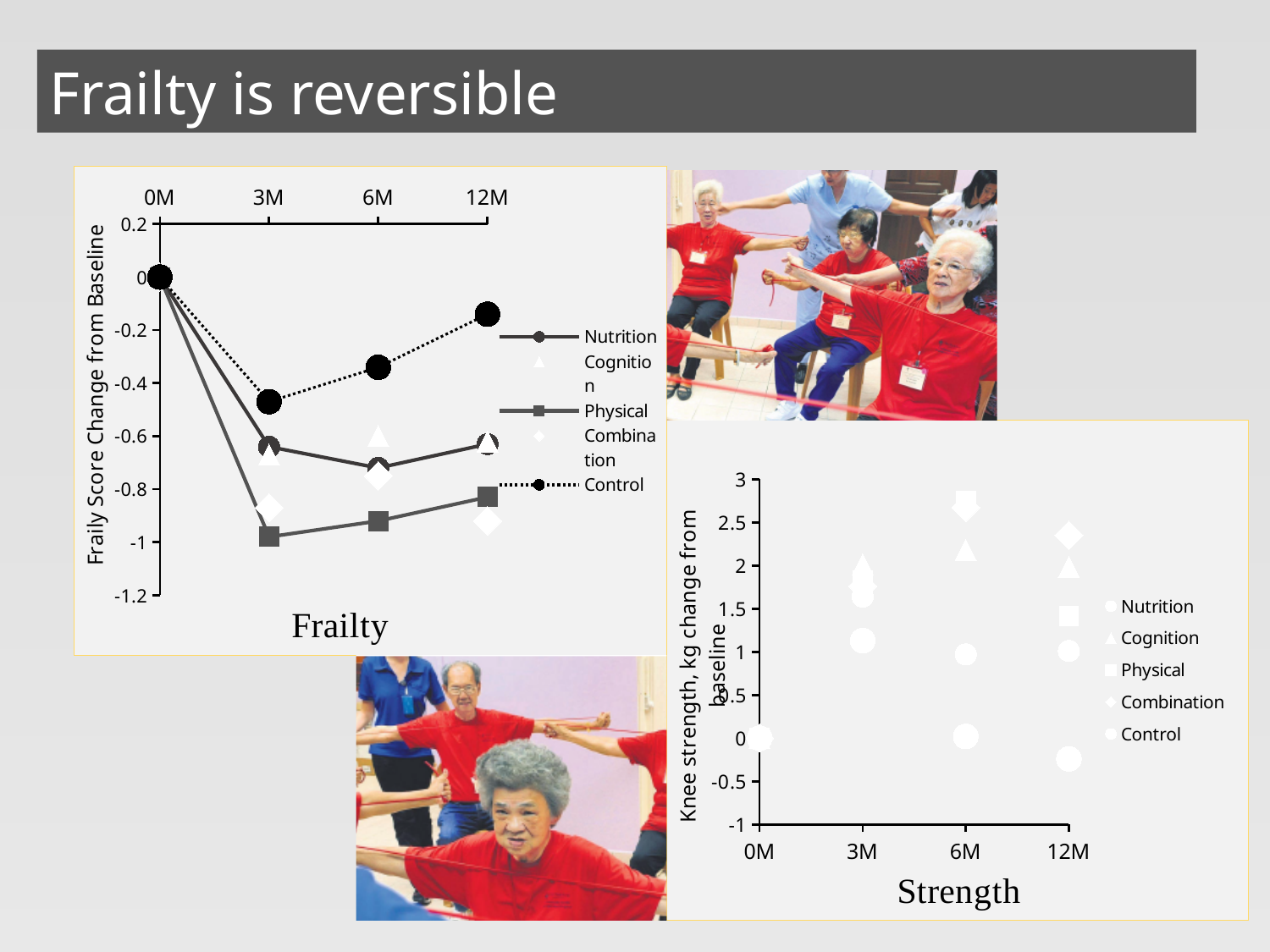
On the Frailty chart, is the value for Physical at 3M greater or less than -0.8? less On the Frailty chart, does the Control series rise or fall from 3M to 12M? rise On the Strength chart, how many series does the legend list? 5 On the Strength chart, what is the label on the y axis? Knee strength, kg change from baseline On the Strength chart, is the value for Control at 12M greater or less than 0? less On the Strength chart, is the value for Physical at 6M greater or less than 2.5? greater On the Frailty chart, what kind of chart is it? line chart On the Frailty chart, how many time points are shown on the x axis? 4 On the Frailty chart, at 12M, which is larger: Control or Physical? Control On the Frailty chart, which series has the lowest value at 3M? Physical On the Frailty chart, how many series does the legend list? 5